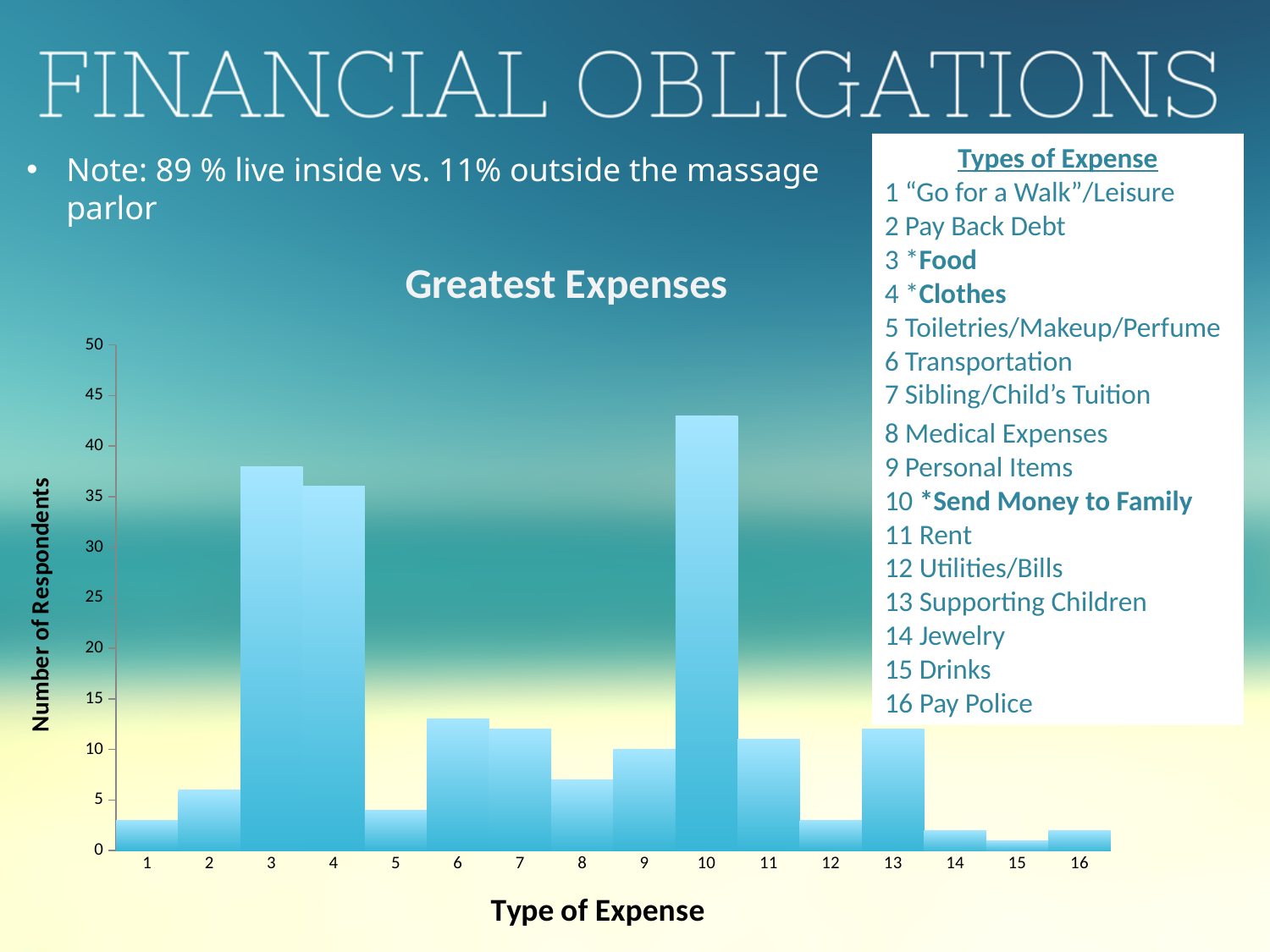
Which has more respondents, type of expense 6 or type of expense 8? 6 Which type of expense has the lowest number of respondents? 15 Is the value for type of expense 3 greater or less than 35? greater Which type of expense has the highest number of respondents? 10 Which has more respondents, type of expense 3 or type of expense 10? 10 What is the label of the vertical axis of the chart? Number of Respondents Is the value for type of expense 10 greater or less than 40? greater Is the value for type of expense 16 greater or less than 5? less What type of chart is shown on the slide? bar chart What is the title of the chart? Greatest Expenses How many expense categories are plotted on the x axis of the chart? 16